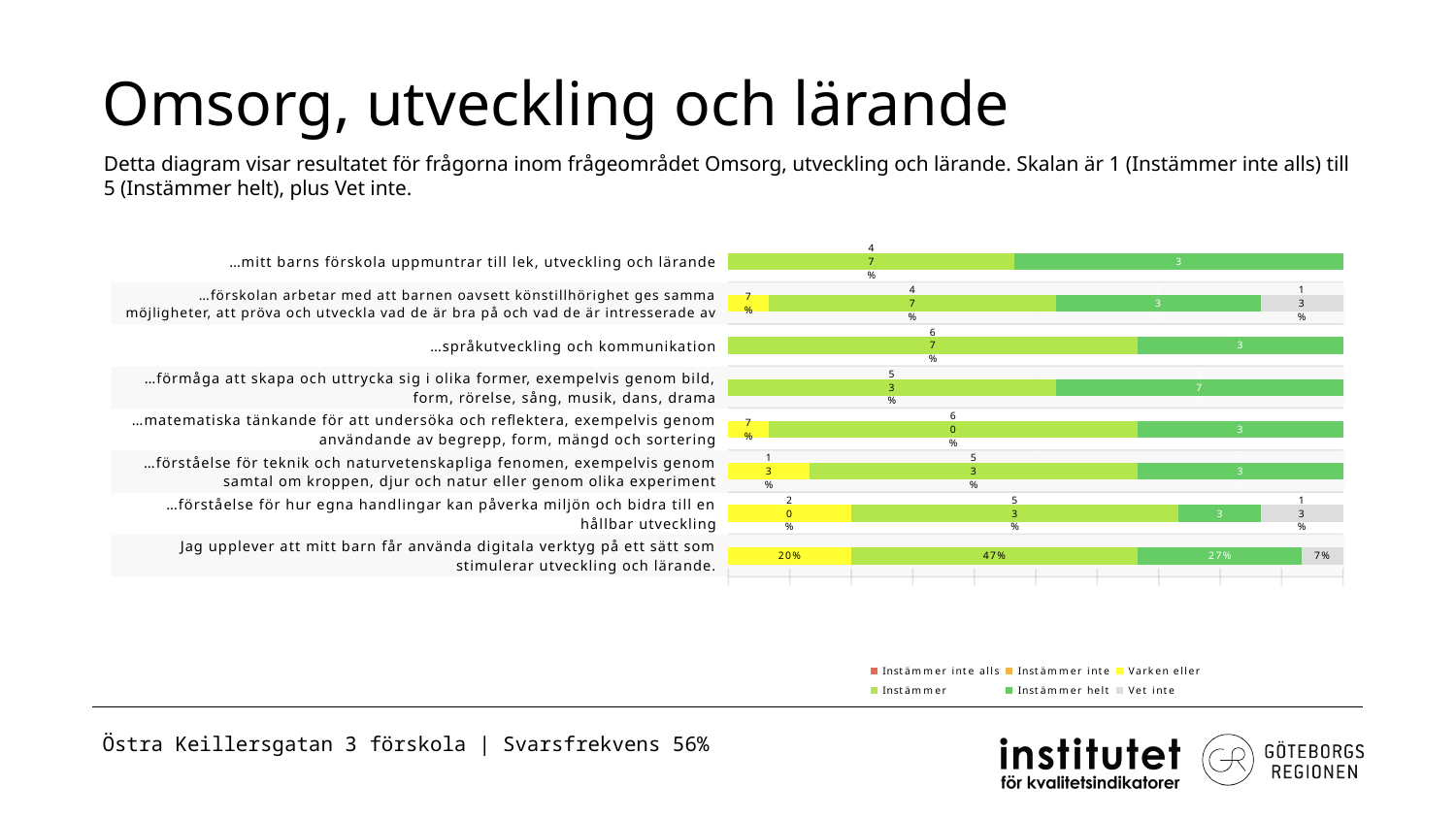
In the bar for "Jag upplever att mitt barn får använda digitala verktyg...", which is larger: Instämmer or Instämmer helt? Instämmer For the category "Jag upplever att mitt barn får använda digitala verktyg på ett sätt som stimulerar utveckling och lärande", what is the value for Varken eller? 20% What kind of chart is shown on the slide? Stacked bar chart In the bar for "Jag upplever att mitt barn får använda digitala verktyg...", what is the difference between Instämmer (47%) and Instämmer helt (27%)? 20 percentage points For the category "Jag upplever att mitt barn får använda digitala verktyg på ett sätt som stimulerar utveckling och lärande", what is the value for Instämmer? 47% Which colour does the legend use for Varken eller? Yellow How many question categories (bars) are shown in the chart? 8 In the bar for "Jag upplever att mitt barn får använda digitala verktyg...", which response category has the largest share? Instämmer How many series does the chart legend list? 6 In the bar for "Jag upplever att mitt barn får använda digitala verktyg...", which response category has the smallest share? Vet inte For the category "Jag upplever att mitt barn får använda digitala verktyg på ett sätt som stimulerar utveckling och lärande", what is the value for Vet inte? 7% For the category "Jag upplever att mitt barn får använda digitala verktyg på ett sätt som stimulerar utveckling och lärande", what is the value for Instämmer helt? 27%